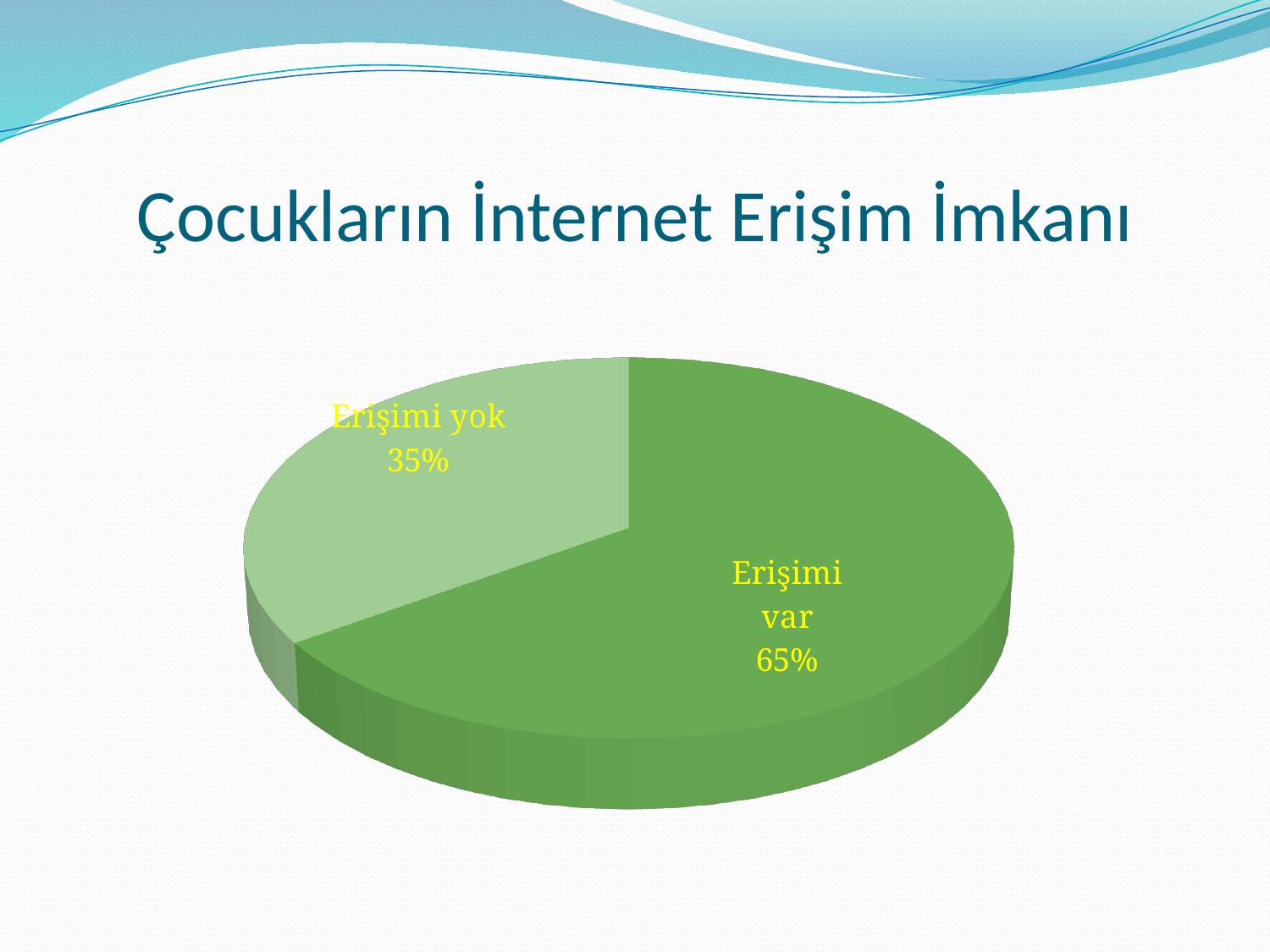
What kind of chart is shown on the slide? pie chart Which slice is the smallest? Erişimi yok What is the difference between the "Erişimi var" and "Erişimi yok" slices? 30% What is the value for "Erişimi yok"? 35% What is the title of the slide containing the chart? Çocukların İnternet Erişim İmkanı Which slice is shown in the darker green colour? Erişimi var What is the value for "Erişimi var"? 65% How many slices does the pie chart have? 2 Which slice is the largest? Erişimi var Which is larger, "Erişimi var" or "Erişimi yok"? Erişimi var What share of the pie does "Erişimi yok" represent? 35%